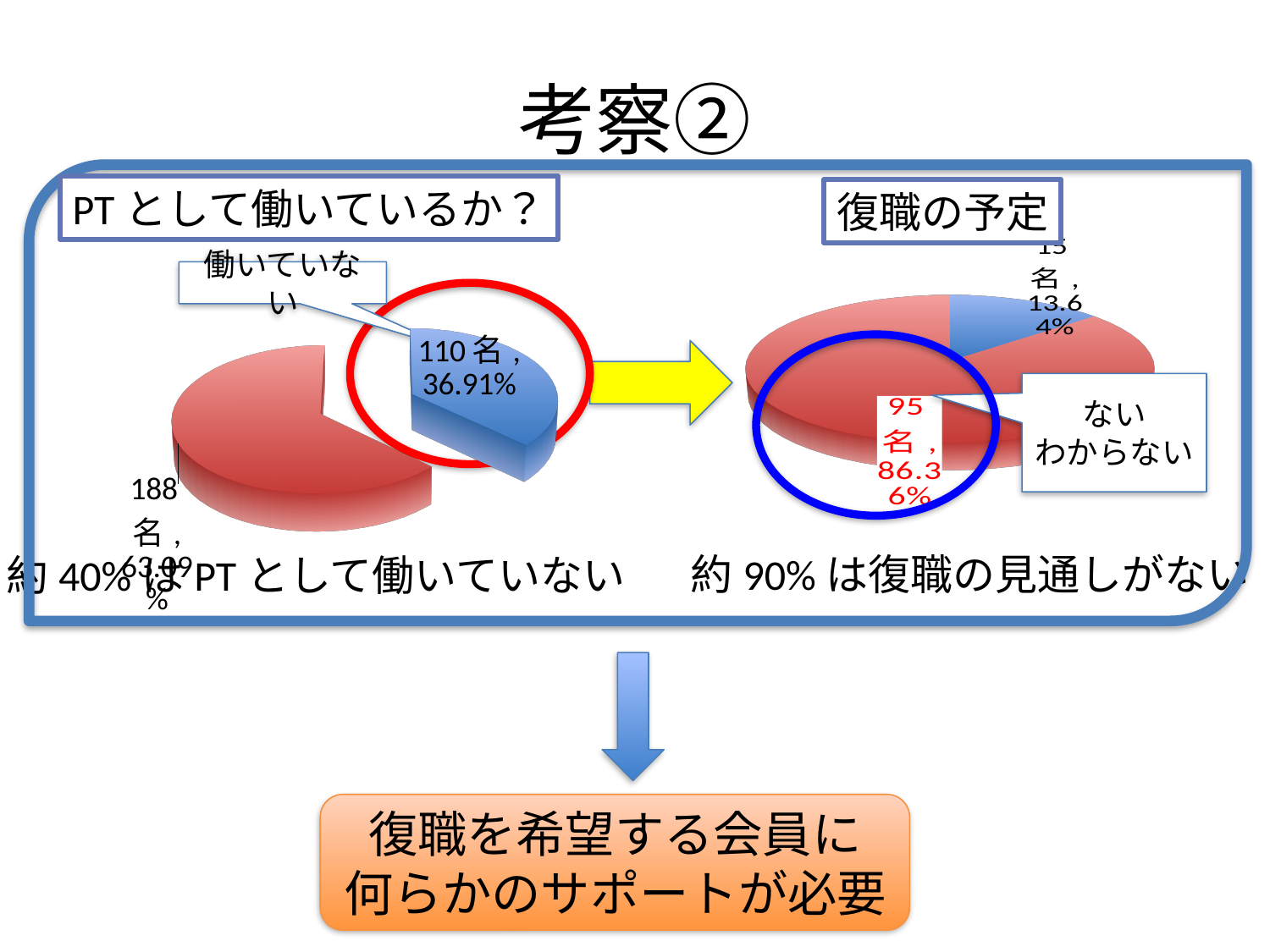
In the left chart 'PTとして働いているか？', what percentage does the '働いていない' slice represent? 36.91% What kind of chart is the left chart titled 'PTとして働いているか？'? Pie chart In the left chart 'PTとして働いているか？', is the '働いていない' slice the larger or the smaller slice? Smaller In the left chart 'PTとして働いているか？', what value is shown for the '働いていない' slice? 110名, 36.91% In the right chart '復職の予定', which slice is the largest? ない・わからない In the right chart '復職の予定', what is the difference in number of people between the 'ない・わからない' slice (95名) and the blue slice (15名)? 80名 How many slices does the left chart 'PTとして働いているか？' have? 2 In the left chart 'PTとして働いているか？', how many people are in the red slice? 188名 In the right chart '復職の予定', what value is shown for the 'ない・わからない' slice? 95名, 86.36% In the right chart '復職の予定', what percentage does the blue slice represent? 13.64% How many slices does the right chart '復職の予定' have? 2 What is the title of the right chart? 復職の予定